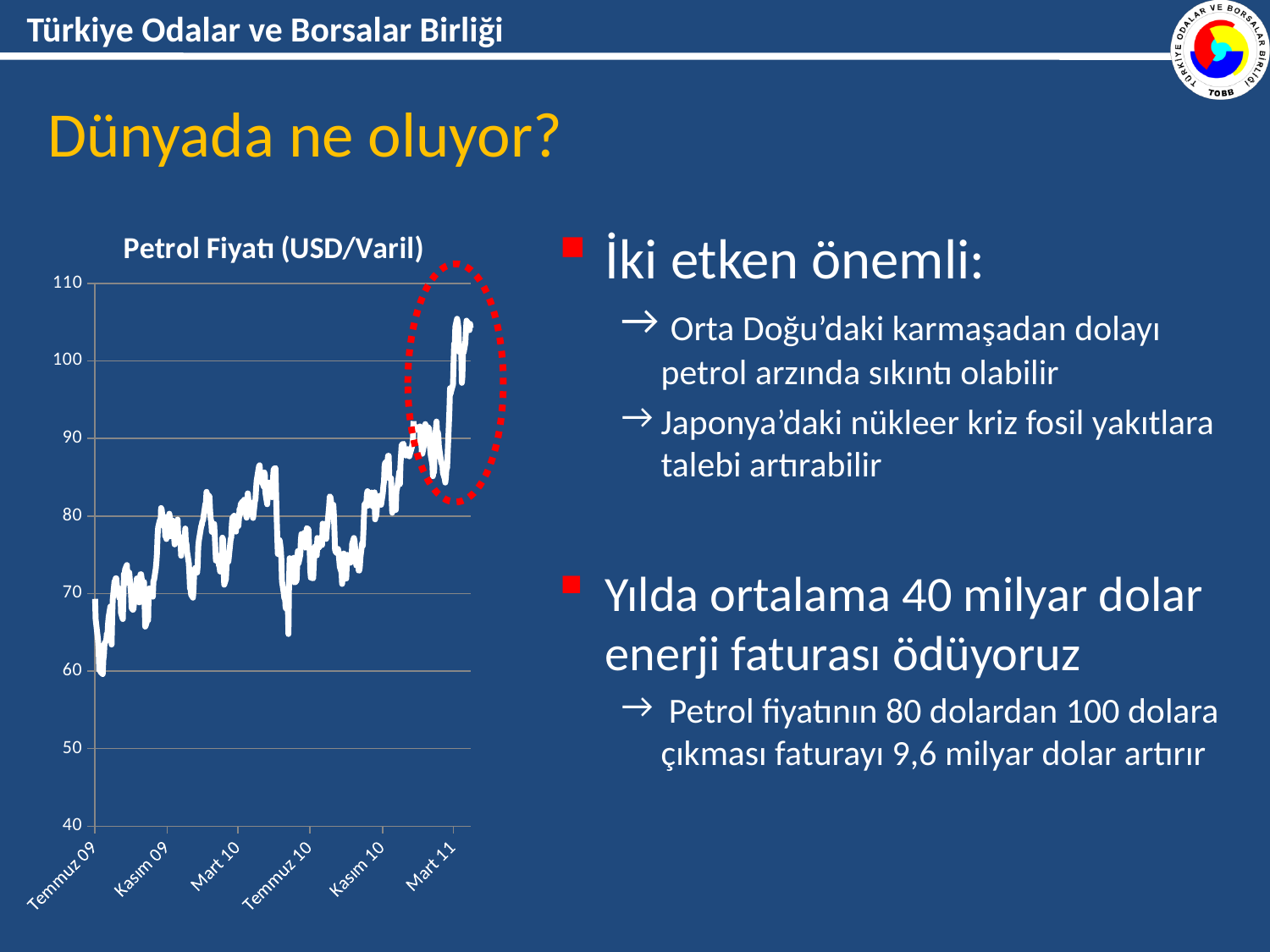
Is the value at Mart 11 larger than the value at Temmuz 09? Yes Overall, do the values in the chart rise or fall from Temmuz 09 to Mart 11? rise What is the highest value shown on the y axis? 110 Is the lowest point of the line greater or less than 70? less Is the value at Kasım 10 greater or less than 100? less What is the title of the chart? Petrol Fiyatı (USD/Varil) Is the value at Temmuz 09 greater or less than 80? less What kind of chart is shown on the slide? line chart How many date labels are shown on the x axis? 6 Which of the labelled dates, Temmuz 09 or Mart 11, has the higher value? Mart 11